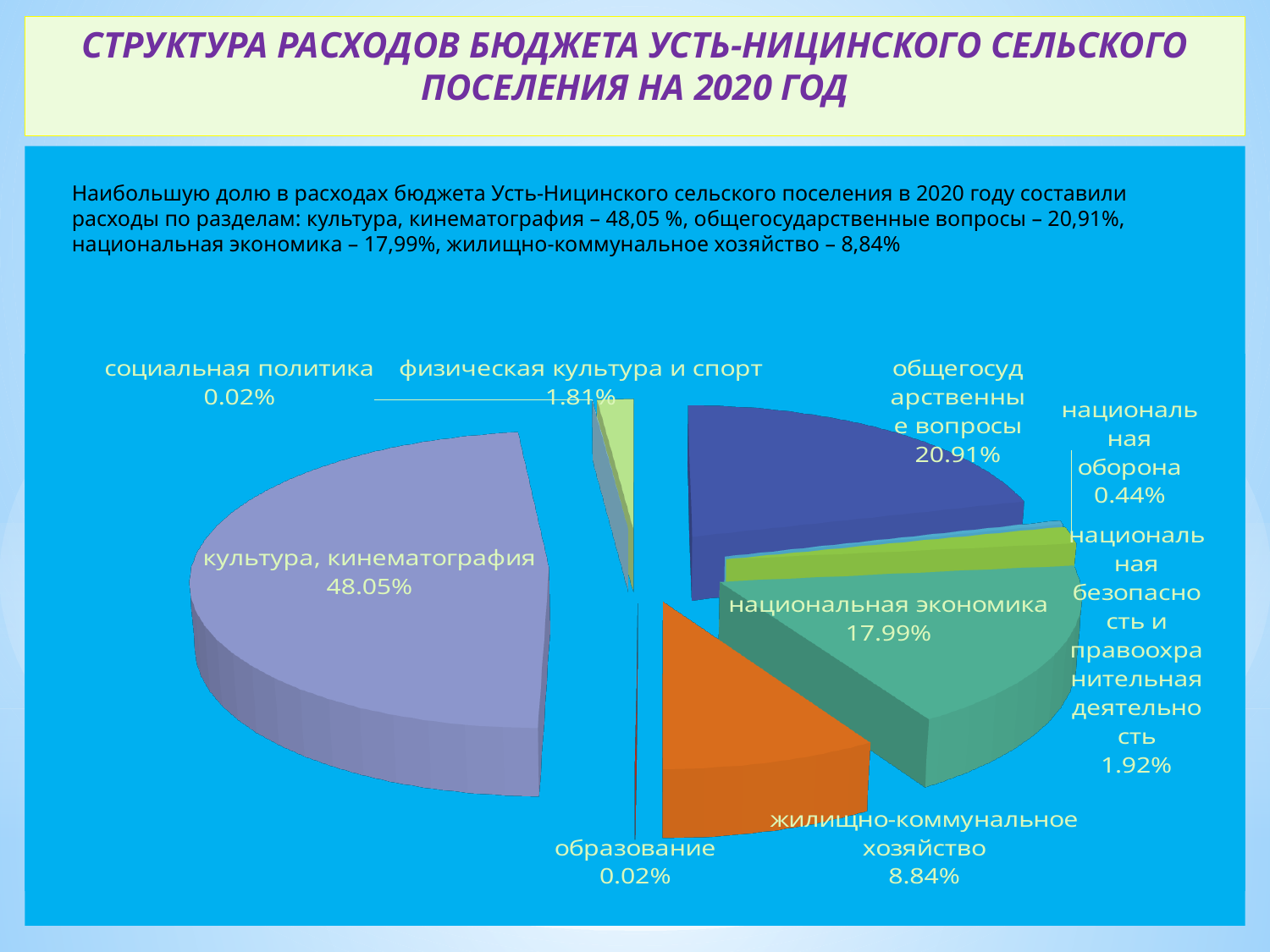
Which category has the largest share of the pie? культура, кинематография What percentage is shown for жилищно-коммунальное хозяйство? 8.84% What share of the budget expenditure goes to культура, кинематография? 48.05% Which is larger: the share for национальная безопасность и правоохранительная деятельность or for физическая культура и спорт? национальная безопасность и правоохранительная деятельность What kind of chart is shown on the slide? pie chart Which is larger: the share for общегосударственные вопросы or for национальная экономика? общегосударственные вопросы What is the value for национальная оборона? 0.44% What share is shown for физическая культура и спорт? 1.81% How many categories are shown in the pie chart? 9 What is the difference between the shares of культура, кинематография and общегосударственные вопросы? 27.14% What is the value shown for общегосударственные вопросы? 20.91% What is the difference between the shares of национальная экономика and жилищно-коммунальное хозяйство? 9.15%